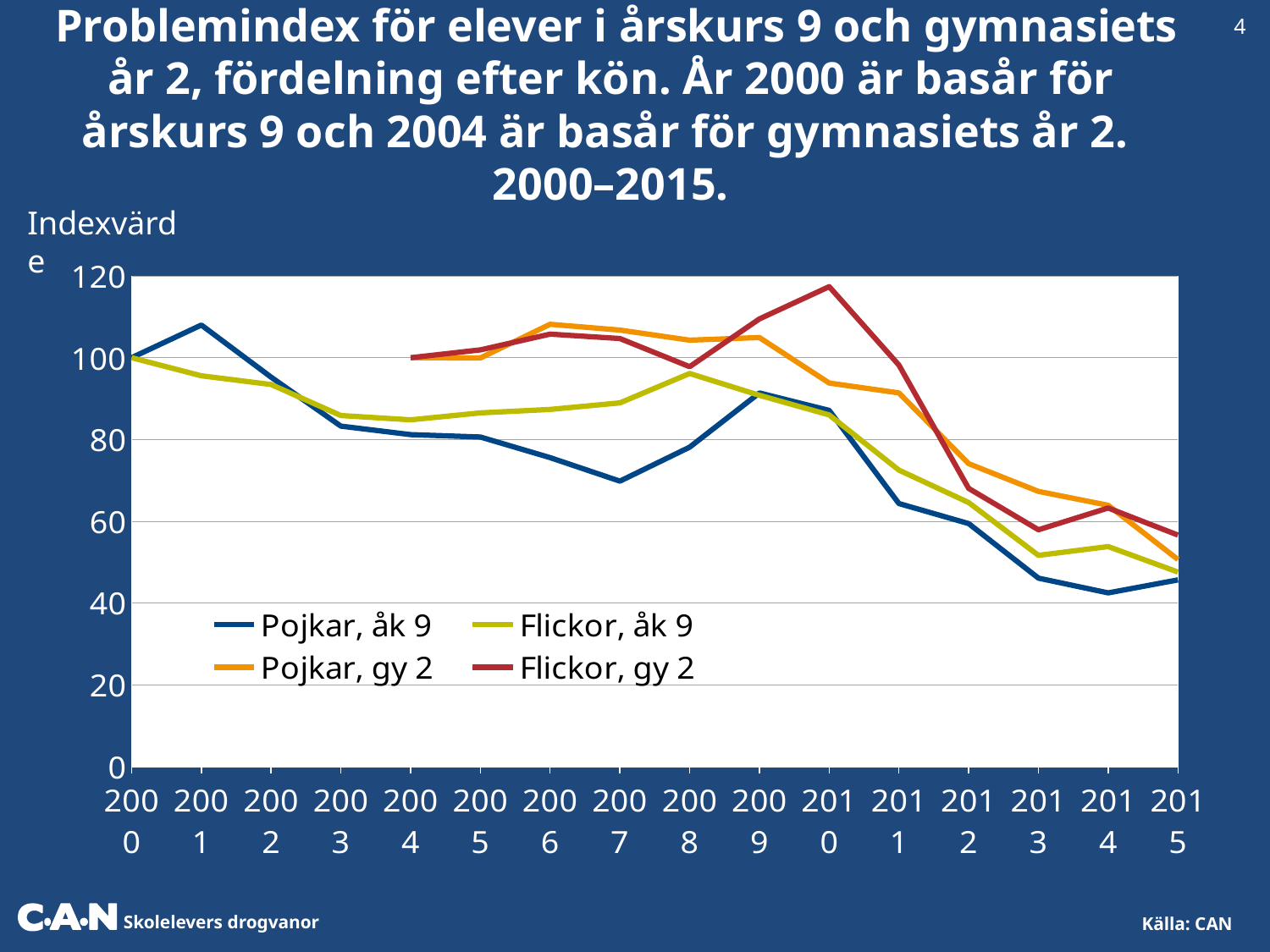
What kind of chart is shown on the slide? line chart How many series does the legend list? 4 Which series has the lowest value in 2013? Pojkar, åk 9 In 2001, which is higher: Pojkar, åk 9 or Flickor, åk 9? Pojkar, åk 9 Does the Pojkar, åk 9 line rise or fall from 2010 to 2015? fall Which series has the highest value in 2010? Flickor, gy 2 Is the value for Pojkar, gy 2 in 2006 greater or less than 100? greater Is the value for Pojkar, åk 9 in 2014 greater or less than 60? less What is the index value for Flickor, gy 2 in 2004? 100 What is the index value for Pojkar, åk 9 in 2000? 100 Is the value for Flickor, gy 2 in 2010 greater or less than 100? greater How many years are shown along the x axis? 16